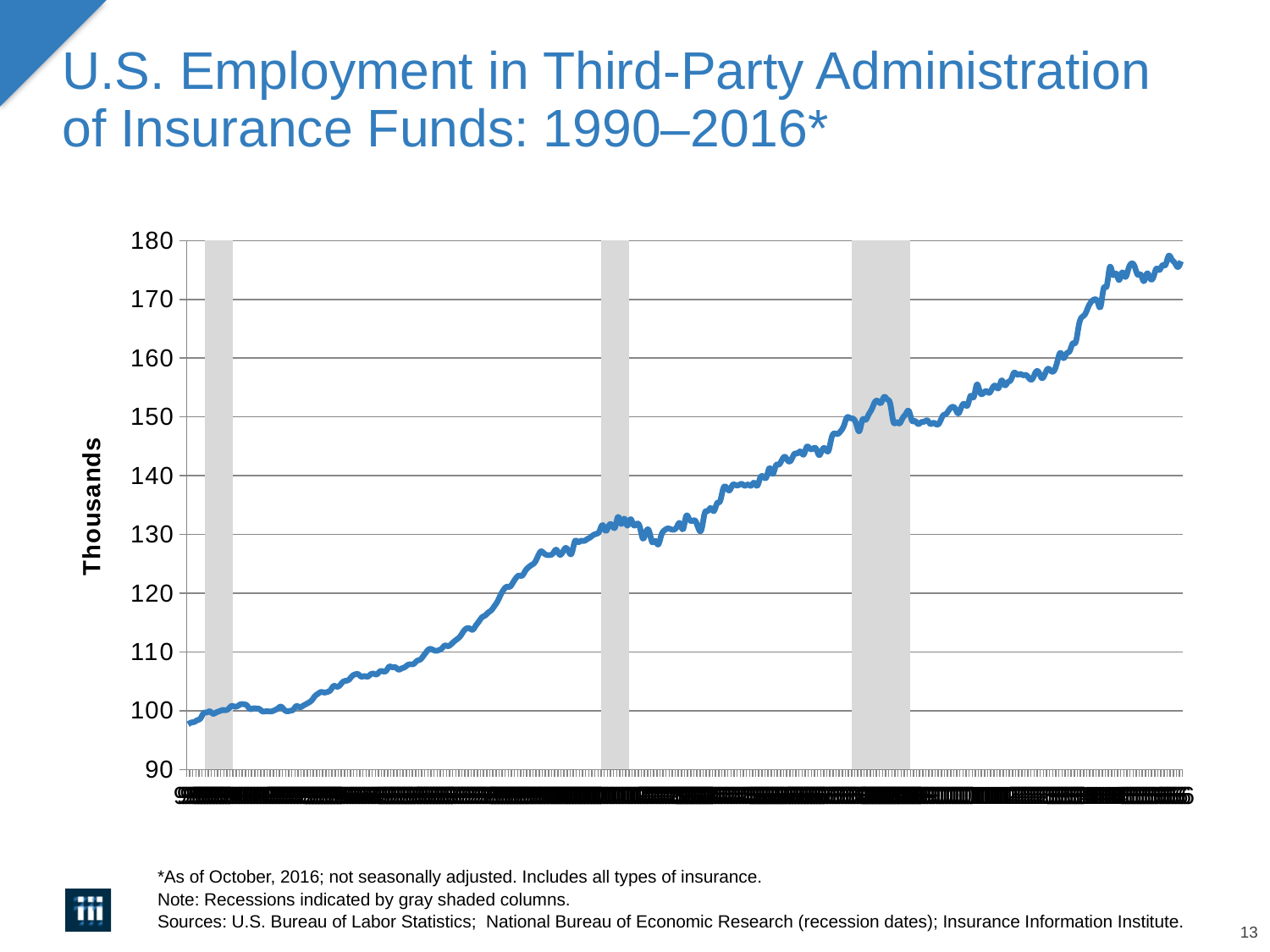
Overall, do the values rise or fall from left to right along the x axis? rise What is the highest value shown on the vertical axis? 180 Is the highest point of the line at the left end or the right end of the chart? right end What kind of chart is shown on the slide? line chart What is the label on the vertical axis? Thousands How many gray shaded recession columns are shown on the chart? 3 Is the value at the left-hand start of the line (1990) greater or less than 110? less Is the peak of the line just before the second gray shaded column greater or less than 140? less Is the lowest point of the line at the left end or the right end of the chart? left end Is the value at the right-hand end of the line (2016) greater or less than 170? greater